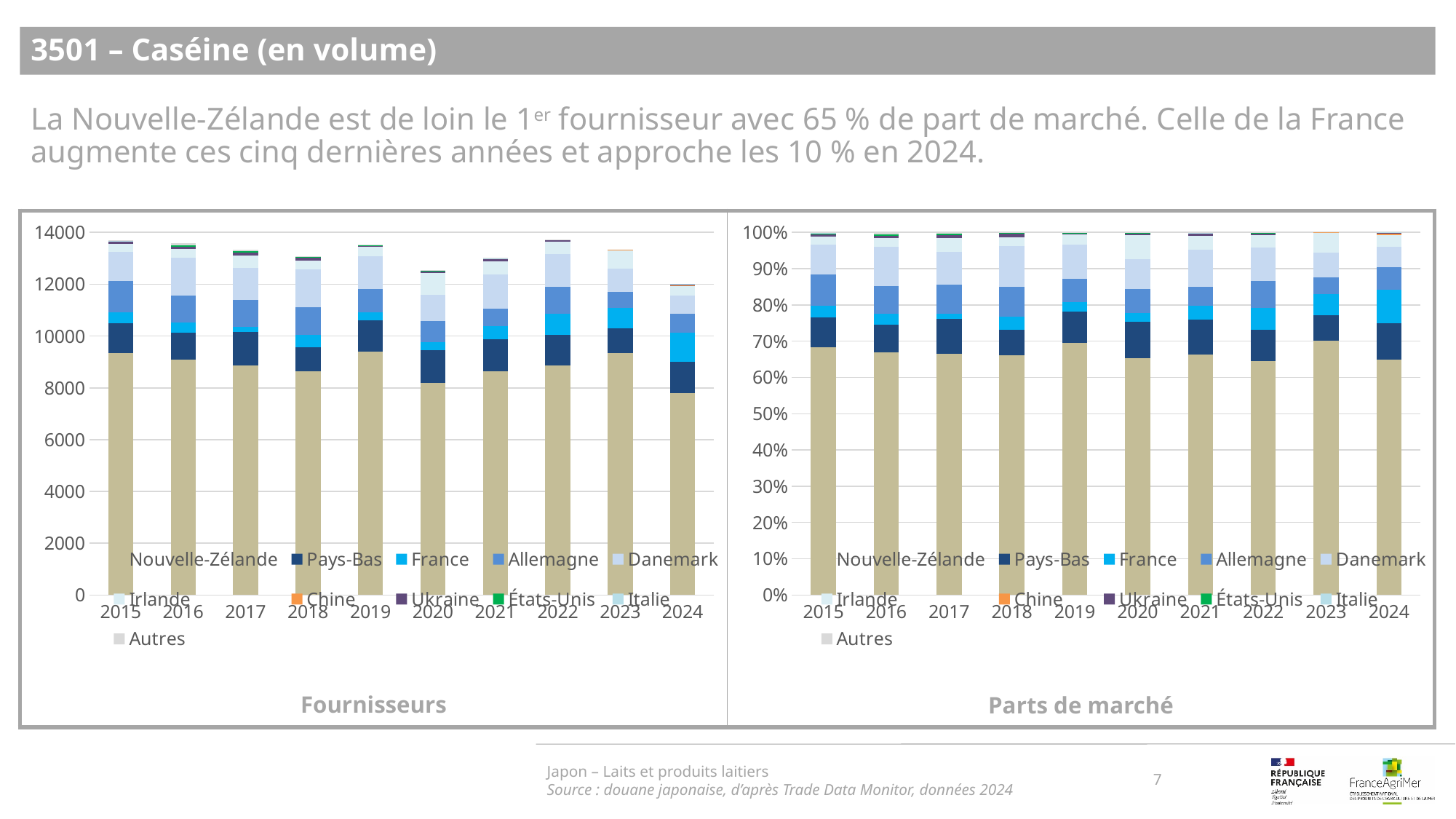
Which series is at the bottom of each stacked bar in both charts? Nouvelle-Zélande What kind of chart is the 'Fournisseurs' chart on the left? Stacked bar chart In the 'Fournisseurs' chart, is the total for 2020 greater or less than 12000? greater In the 'Fournisseurs' chart, which year has the lowest total bar? 2024 How many years are shown on the x axis of the 'Parts de marché' chart? 10 In the 'Fournisseurs' chart, is the total bar for 2020 or for 2024 larger? 2020 In the 'Fournisseurs' chart, is the Nouvelle-Zélande segment for 2024 greater or less than 8000? less What is the title of the chart on the right of the slide? Parts de marché In the 'Fournisseurs' chart, do the total bars rise or fall from 2022 to 2024? fall In the 'Parts de marché' chart, is the Nouvelle-Zélande share for 2024 greater or less than 60%? greater How many series does the legend of the 'Fournisseurs' chart list? 11